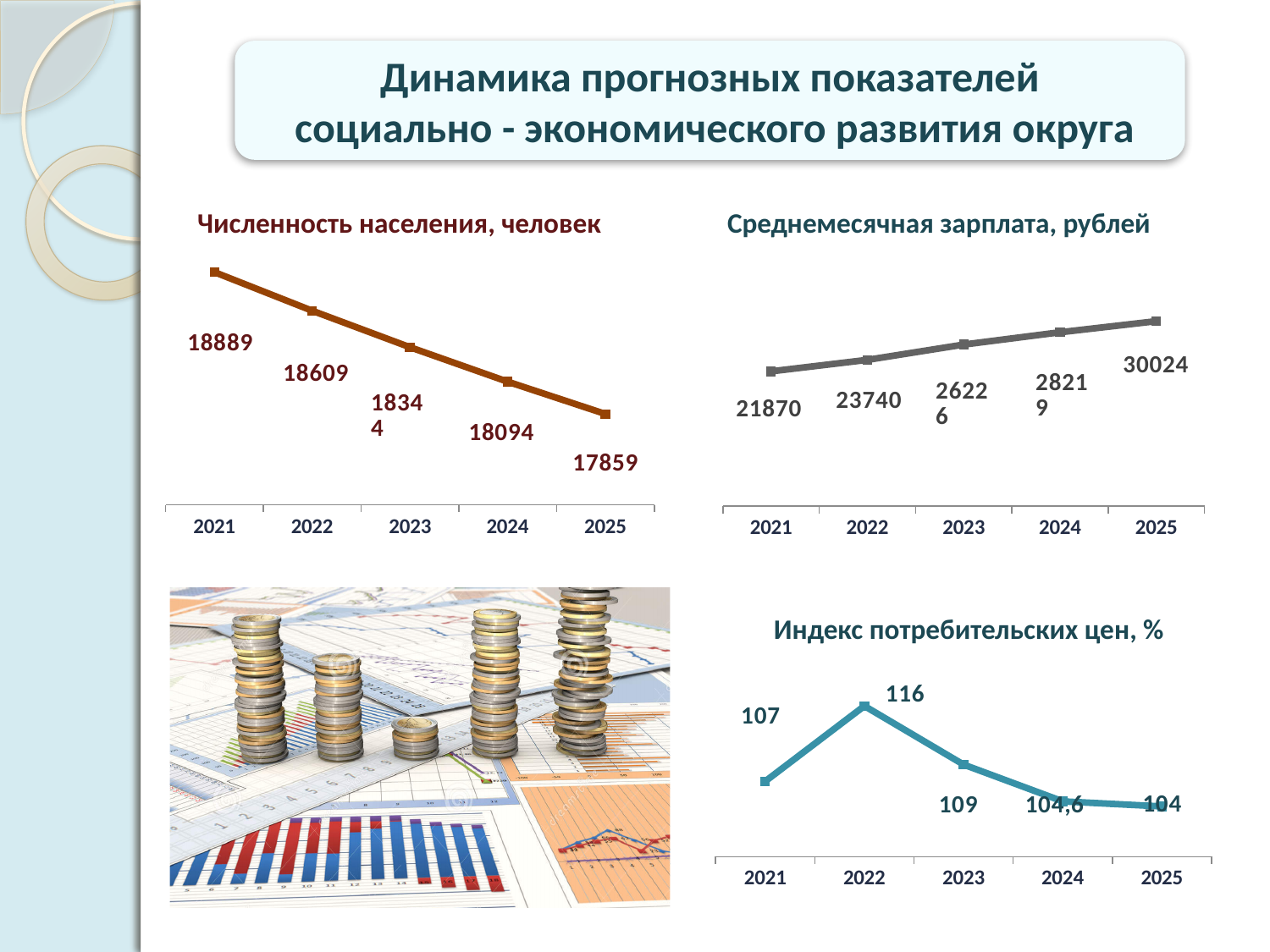
In the chart titled 'Среднемесячная зарплата, рублей', which year has the highest value? 2025 In the chart titled 'Среднемесячная зарплата, рублей', what is the value for 2022? 23740 In the chart titled 'Численность населения, человек', what is the difference between the 2021 and 2025 values? 1030 In the chart titled 'Среднемесячная зарплата, рублей', how many years are plotted? 5 In the chart titled 'Численность населения, человек', do the values rise or fall from 2021 to 2025? fall What kind of chart is the chart titled 'Индекс потребительских цен, %'? line chart In the chart titled 'Численность населения, человек', what is the value for 2021? 18889 In the chart titled 'Индекс потребительских цен, %', which year has the highest value? 2022 In the chart titled 'Индекс потребительских цен, %', what is the value for 2024? 104,6 In the chart titled 'Численность населения, человек', what is the value for 2025? 17859 In the chart titled 'Индекс потребительских цен, %', which is larger, the value for 2021 or the value for 2023? 2023 In the chart titled 'Среднемесячная зарплата, рублей', what is the difference between the 2025 and 2021 values? 8154